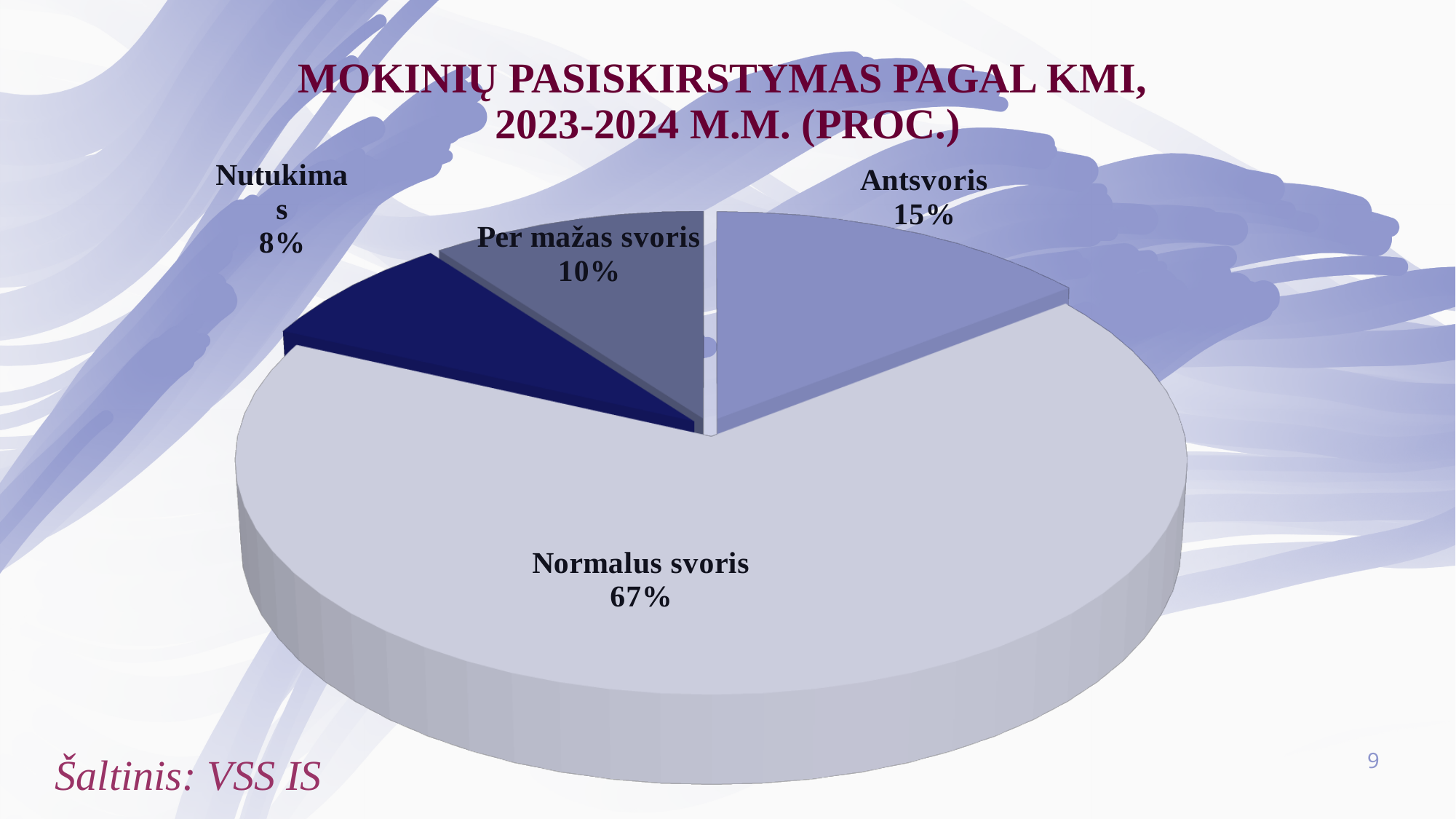
What kind of chart is shown on the slide? Pie chart Which category has the smallest share of the pie? Nutukimas How many categories does the pie chart show? 4 Which is larger, the share for Antsvoris or the share for Per mažas svoris? Antsvoris What percentage of pupils have Per mažas svoris? 10% Which category has the largest share of the pie? Normalus svoris What is the difference in percentage points between Antsvoris and Nutukimas? 7 What percentage of pupils have Antsvoris? 15% What is the combined share of Antsvoris and Nutukimas? 23% What is the title of the chart? MOKINIŲ PASISKIRSTYMAS PAGAL KMI, 2023-2024 M.M. (PROC.) What percentage of pupils have Nutukimas? 8% What percentage of pupils have Normalus svoris? 67%